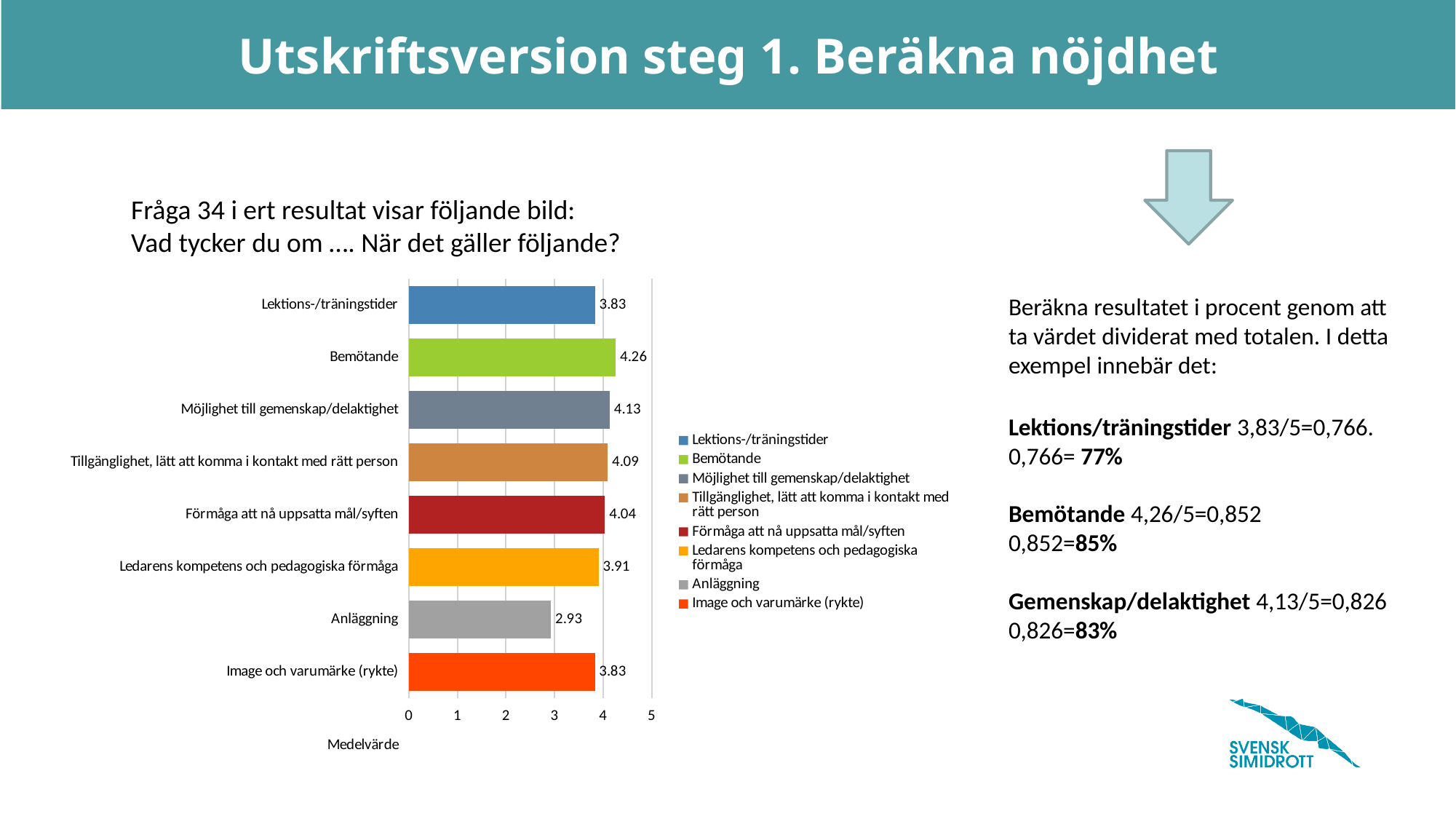
What is the difference between the values for Bemötande and Anläggning? 1.33 Which is larger, the value for Tillgänglighet, lätt att komma i kontakt med rätt person or the value for Förmåga att nå uppsatta mål/syften? Tillgänglighet, lätt att komma i kontakt med rätt person What is the difference between the values for Möjlighet till gemenskap/delaktighet and Ledarens kompetens och pedagogiska förmåga? 0.22 How many categories are shown in the chart? 8 How many entries does the legend list? 8 What is the value for Anläggning? 2.93 Which category has the highest value? Bemötande What is the value for Bemötande? 4.26 What is the value for Ledarens kompetens och pedagogiska förmåga? 3.91 What kind of chart is shown on the slide? bar chart Which category has the lowest value? Anläggning Is the value for Anläggning greater or less than 3? less